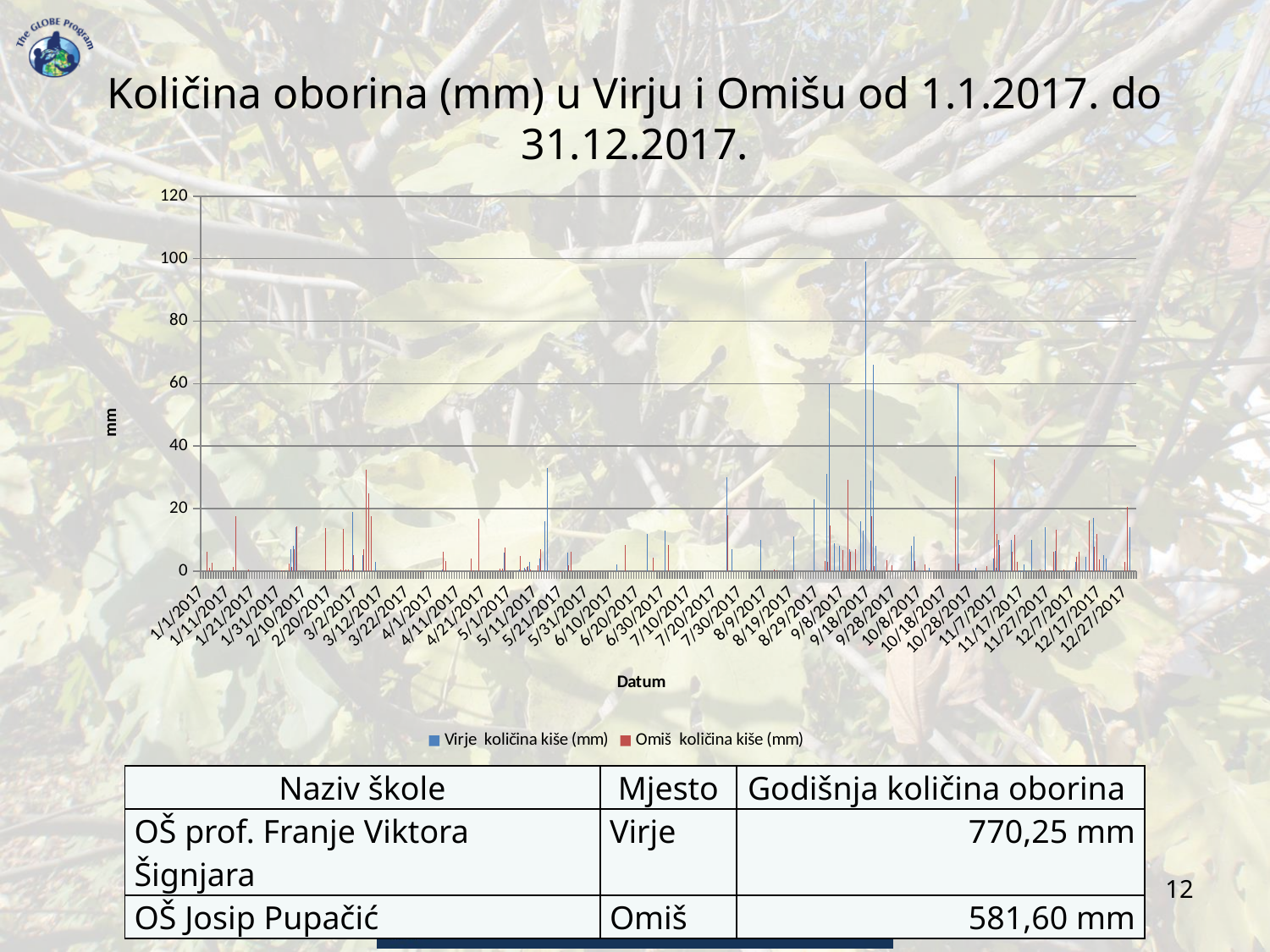
Is the highest daily value for Omiš greater or less than 60? less Which series contains the single highest daily value in the chart? Virje količina kiše (mm) What kind of chart is shown on the slide? bar chart What is the title of the chart on the slide? Količina oborina (mm) u Virju i Omišu od 1.1.2017. do 31.12.2017. Is the highest daily value for Virje greater or less than 120? less How many series does the chart legend list? 2 Is the highest daily value for Virje greater or less than 80? greater What are the two series named in the chart legend? Virje količina kiše (mm) and Omiš količina kiše (mm)